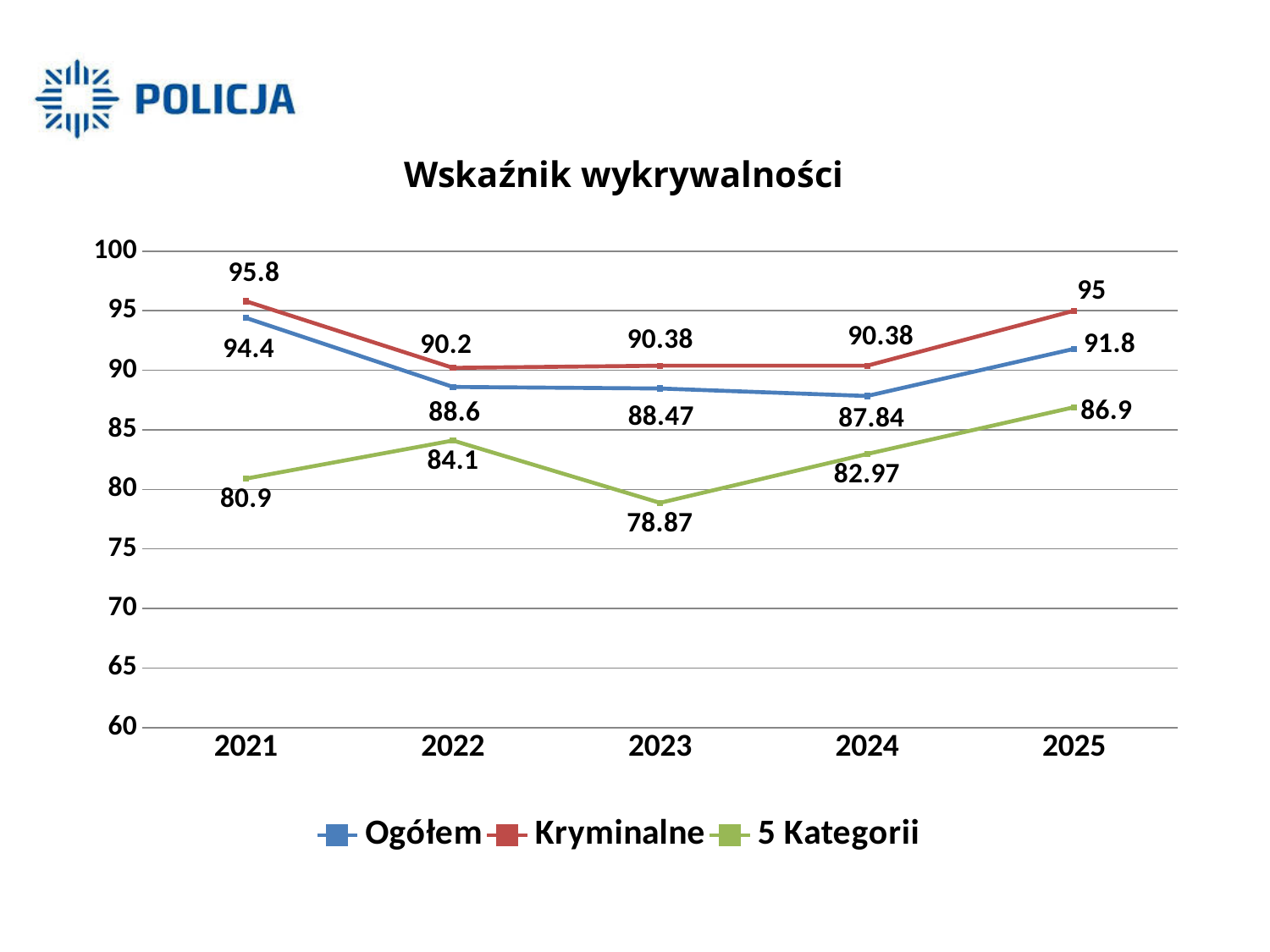
Which is larger in 2022: Ogółem or 5 Kategorii? Ogółem What is the title of the chart? Wskaźnik wykrywalności In which year is the 5 Kategorii series lowest? 2023 What is the value for Kryminalne in 2021? 95.8 How many series does the legend list? 3 What is the value for Ogółem in 2024? 87.84 What is the difference between the Kryminalne and Ogółem values in 2025? 3.2 Does the Ogółem series rise or fall from 2021 to 2024? fall How many years are shown on the x axis? 5 What is the value for 5 Kategorii in 2023? 78.87 In which year is the Kryminalne series highest? 2021 What kind of chart is this? line chart